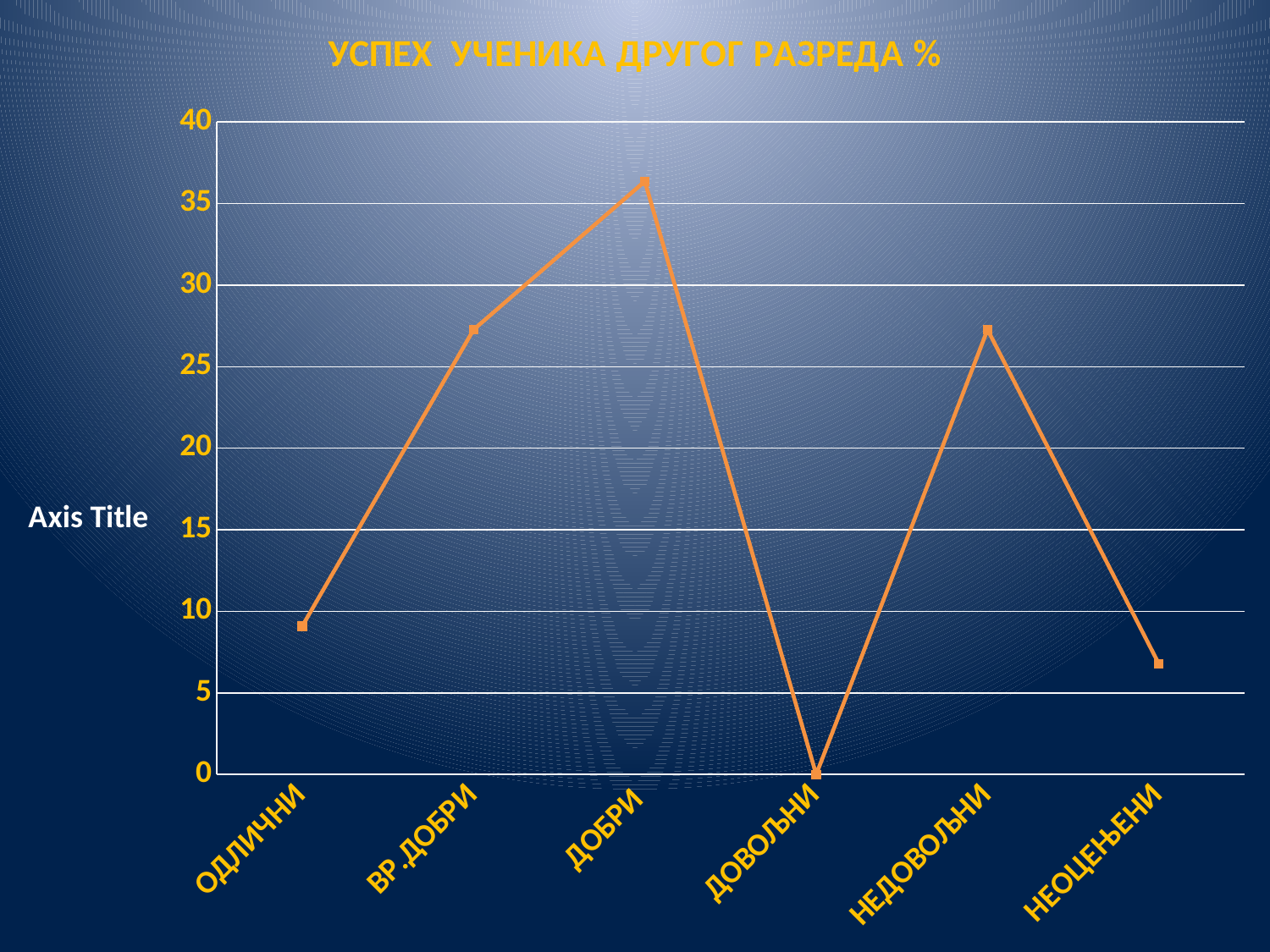
Which category has the lowest value? ДОВОЉНИ Is the value for ДОБРИ greater or less than 35? greater What is the label shown on the vertical axis? Axis Title How many categories are plotted on the x axis? 6 Which is larger, the value for ДОБРИ or the value for ОДЛИЧНИ? ДОБРИ Is the value for ВР.ДОБРИ greater or less than 25? greater What type of chart is shown on the slide? line chart Is the value for ОДЛИЧНИ greater or less than 10? less What is the title of the chart? УСПЕХ УЧЕНИКА ДРУГОГ РАЗРЕДА % What is the value for ДОВОЉНИ? 0 Which category has the highest value? ДОБРИ